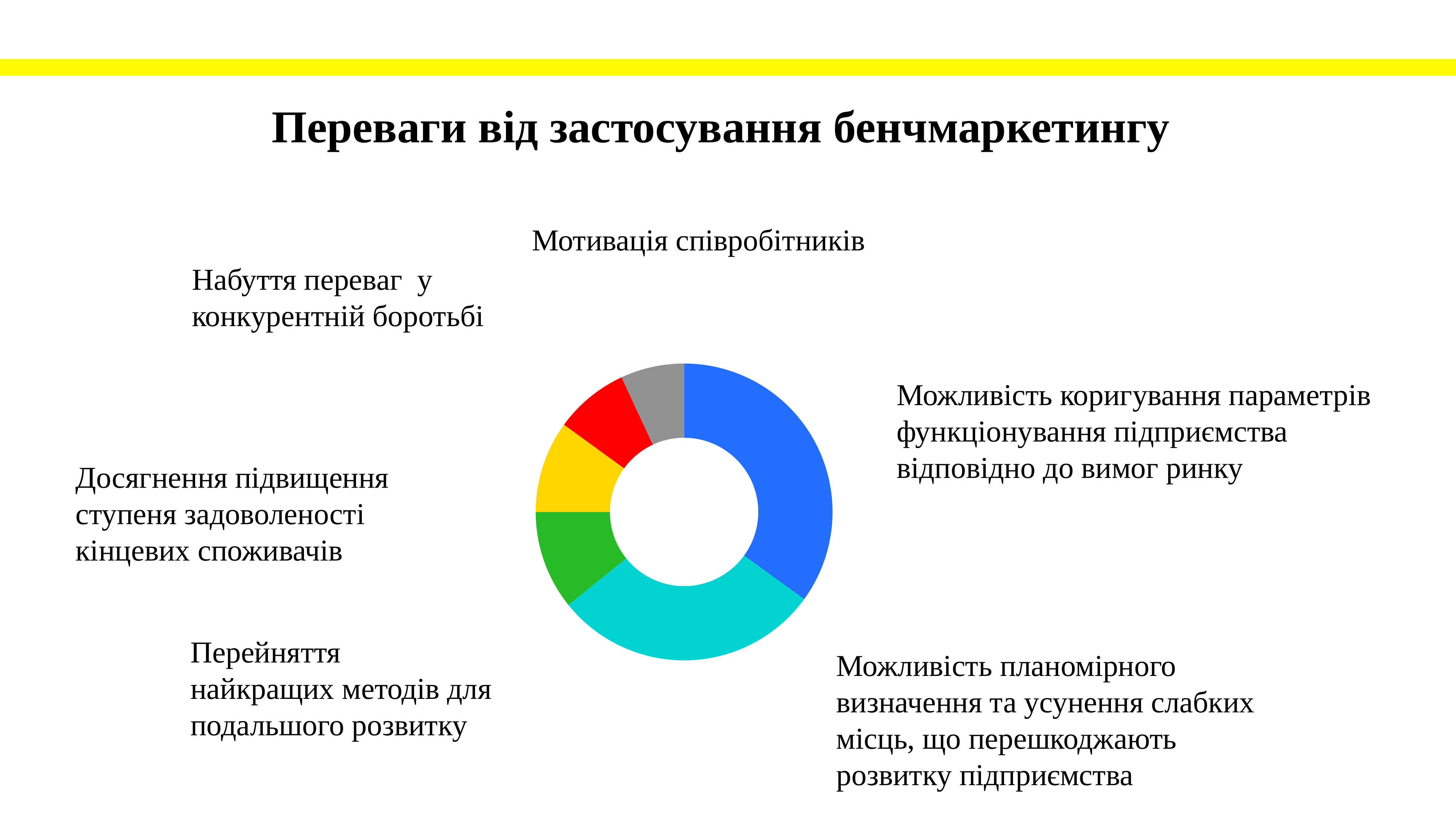
What kind of chart is shown on the slide? Doughnut chart What is the title of the slide containing the doughnut chart? Переваги від застосування бенчмаркетингу Which colour slice is the largest in the doughnut chart? Blue Which is larger in the doughnut chart, the blue slice or the grey slice? The blue slice Which is larger in the doughnut chart, the blue slice or the cyan slice? The blue slice Does the doughnut chart display a legend? No How many slices does the doughnut chart have? 6 Which is larger in the doughnut chart, the cyan slice or the green slice? The cyan slice